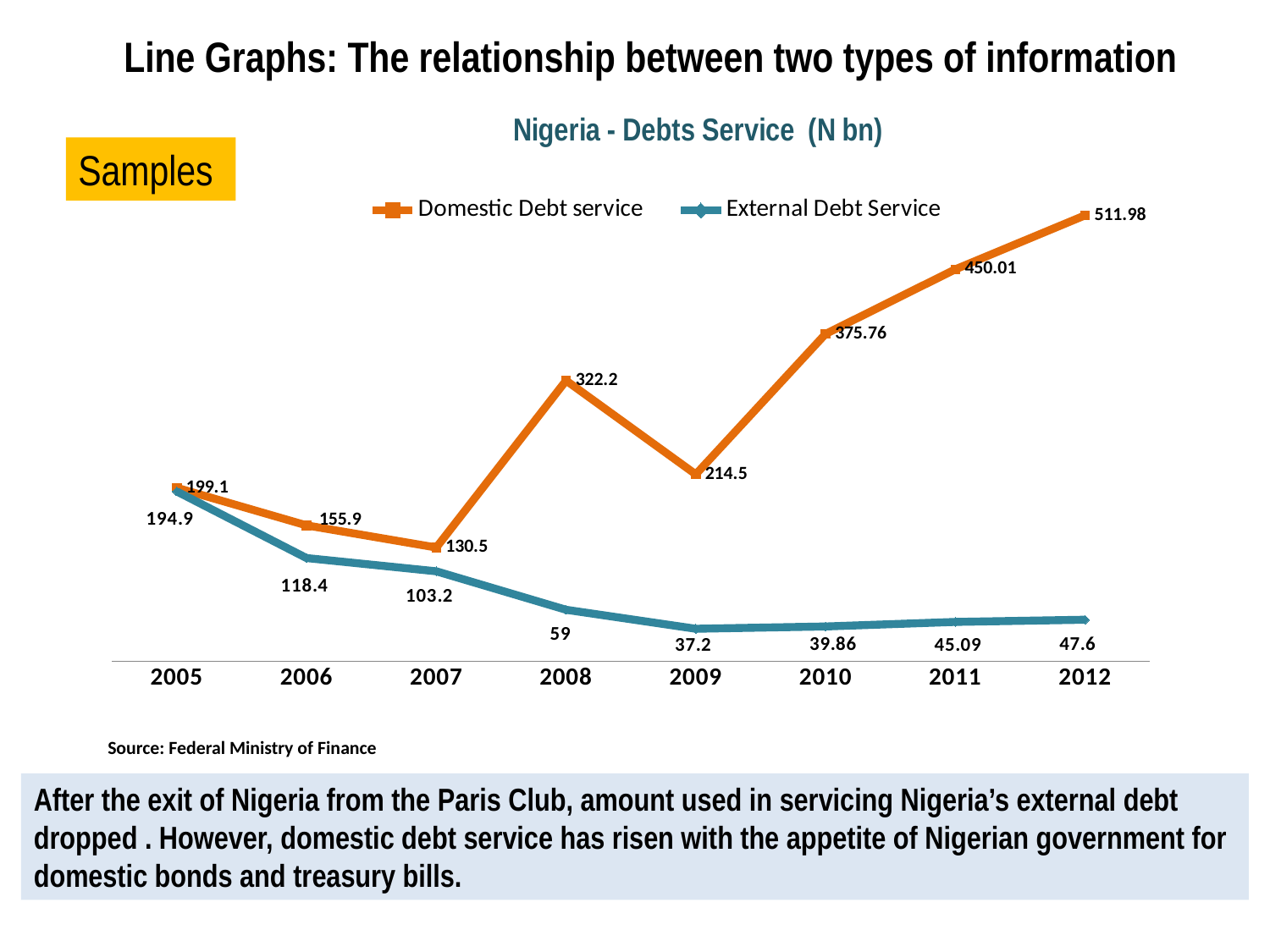
Does the External Debt Service value rise or fall from 2005 to 2009? Fall Which year has the lowest External Debt Service value? 2009 How many series does the legend list? 2 Which is larger in 2007: Domestic Debt service or External Debt Service? Domestic Debt service What is the Domestic Debt service value for 2008? 322.2 What kind of chart is shown on the slide? Line chart What is the difference between Domestic Debt service in 2012 and 2011? 61.97 What is the External Debt Service value for 2009? 37.2 How many years are shown on the x axis? 8 What is the Domestic Debt service value for 2012? 511.98 What is the title of the chart? Nigeria - Debts Service (N bn) Which year has the highest Domestic Debt service value? 2012